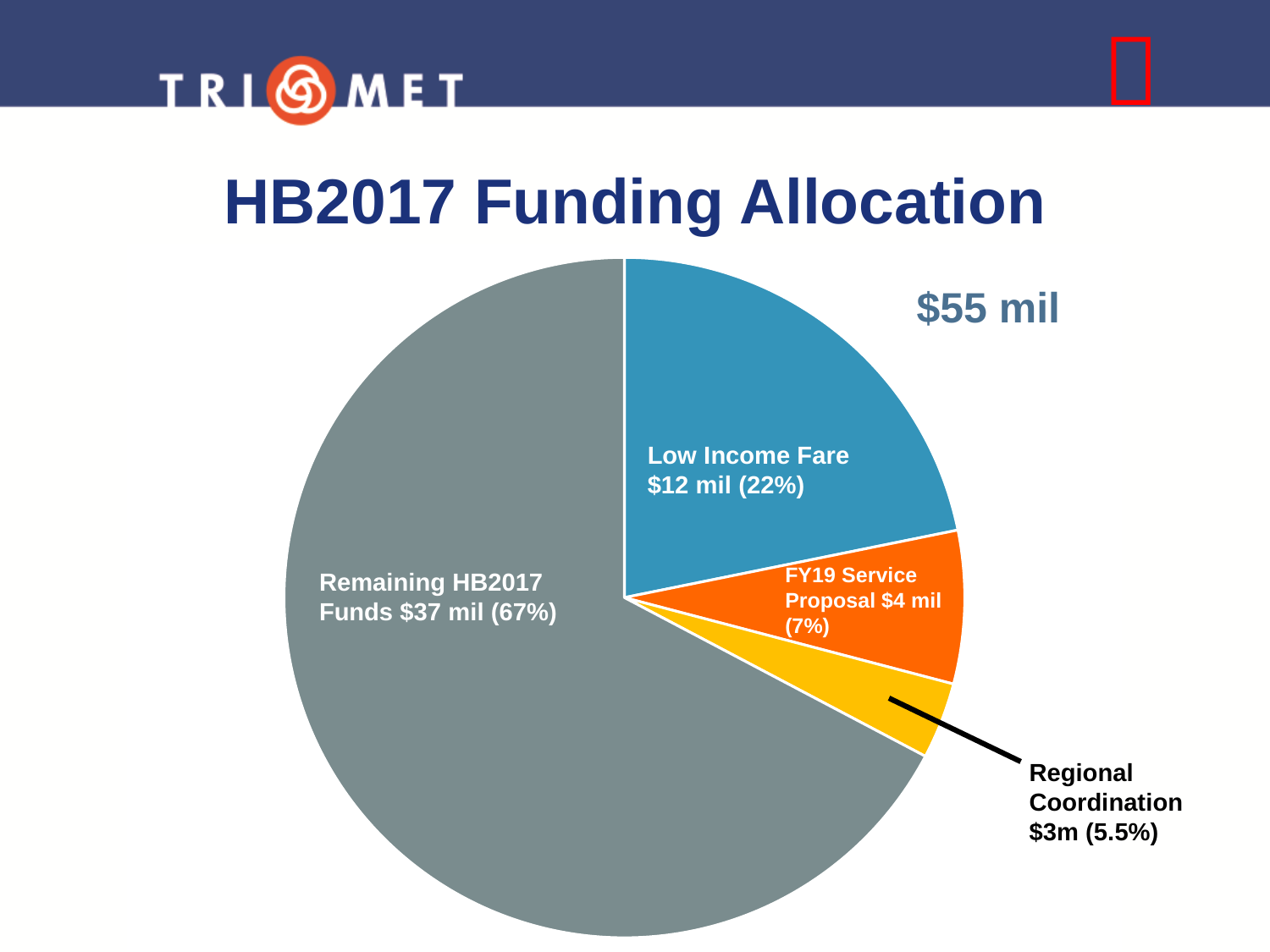
What type of chart is shown on the slide? Pie chart What amount is allocated to Low Income Fare? $12 mil Which slice is the largest? Remaining HB2017 Funds What is the title of the chart? HB2017 Funding Allocation Which slice is the smallest? Regional Coordination How many slices does the pie chart have? 4 What amount is shown for Regional Coordination? $3m What amount is allocated to the FY19 Service Proposal? $4 mil What share of the pie is Regional Coordination? 5.5% What is the difference in dollars between Remaining HB2017 Funds and Low Income Fare? $25 mil Which is larger, Low Income Fare or FY19 Service Proposal? Low Income Fare What share of the pie is Remaining HB2017 Funds? 67%